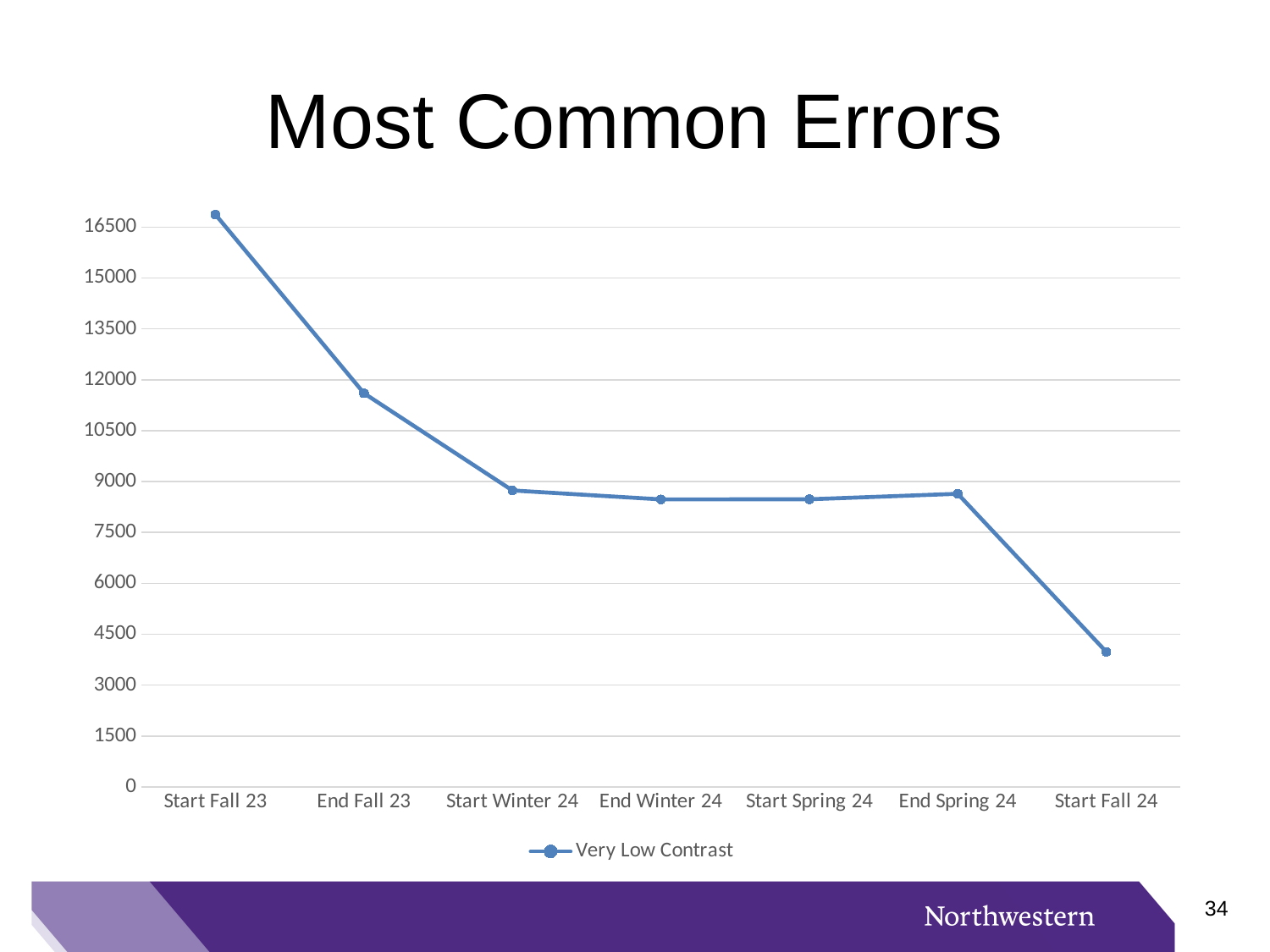
Which category has the lowest value for Very Low Contrast? Start Fall 24 How many series does the legend list? 1 Is the value for Start Fall 24 greater or less than 4500? less Which category has the highest value for Very Low Contrast? Start Fall 23 Is the value for End Fall 23 greater or less than 12000? less How many data points are plotted on the line? 7 Is the value for Start Fall 23 greater or less than 16500? greater Overall, do the values rise or fall from Start Fall 23 to Start Fall 24? fall What type of chart is shown on the slide? line chart What is the name of the series shown in the legend? Very Low Contrast What is the title of the chart? Most Common Errors Which is larger, the value for End Fall 23 or the value for Start Winter 24? End Fall 23